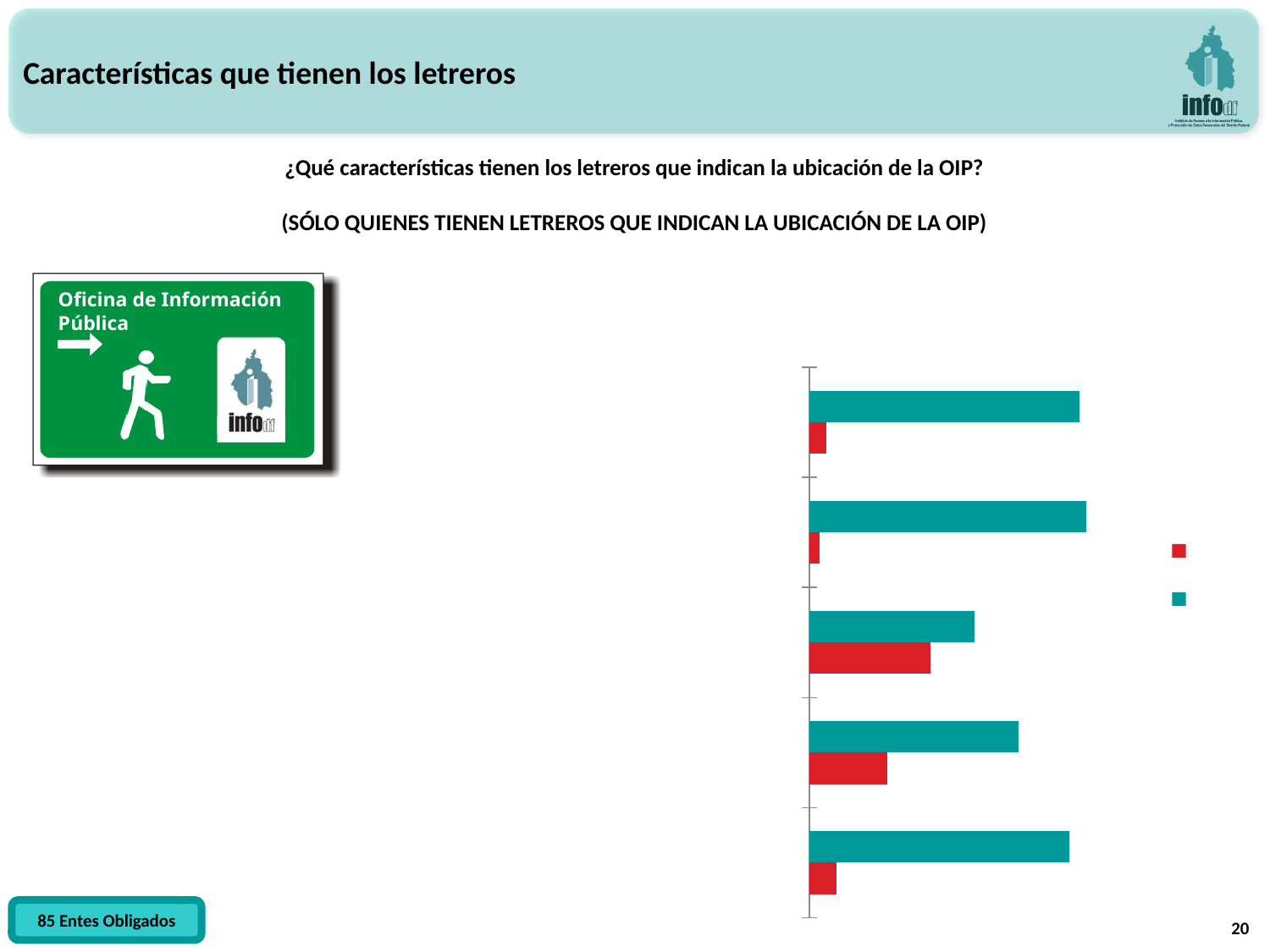
What two colours are used for the bars in the chart? teal and red How many series does the chart's legend list? 2 In the bottom group of bars, which bar is longer, the teal one or the red one? the teal one Are the bars in the chart horizontal or vertical? horizontal Which group of bars, counting from the top, has the shortest teal bar? the third group How many groups of bars are plotted in the chart? 5 In the topmost group of bars, which bar is longer, the teal one or the red one? the teal one What kind of chart is shown on the slide? bar chart Which group of bars, counting from the top, has the longest red bar? the third group